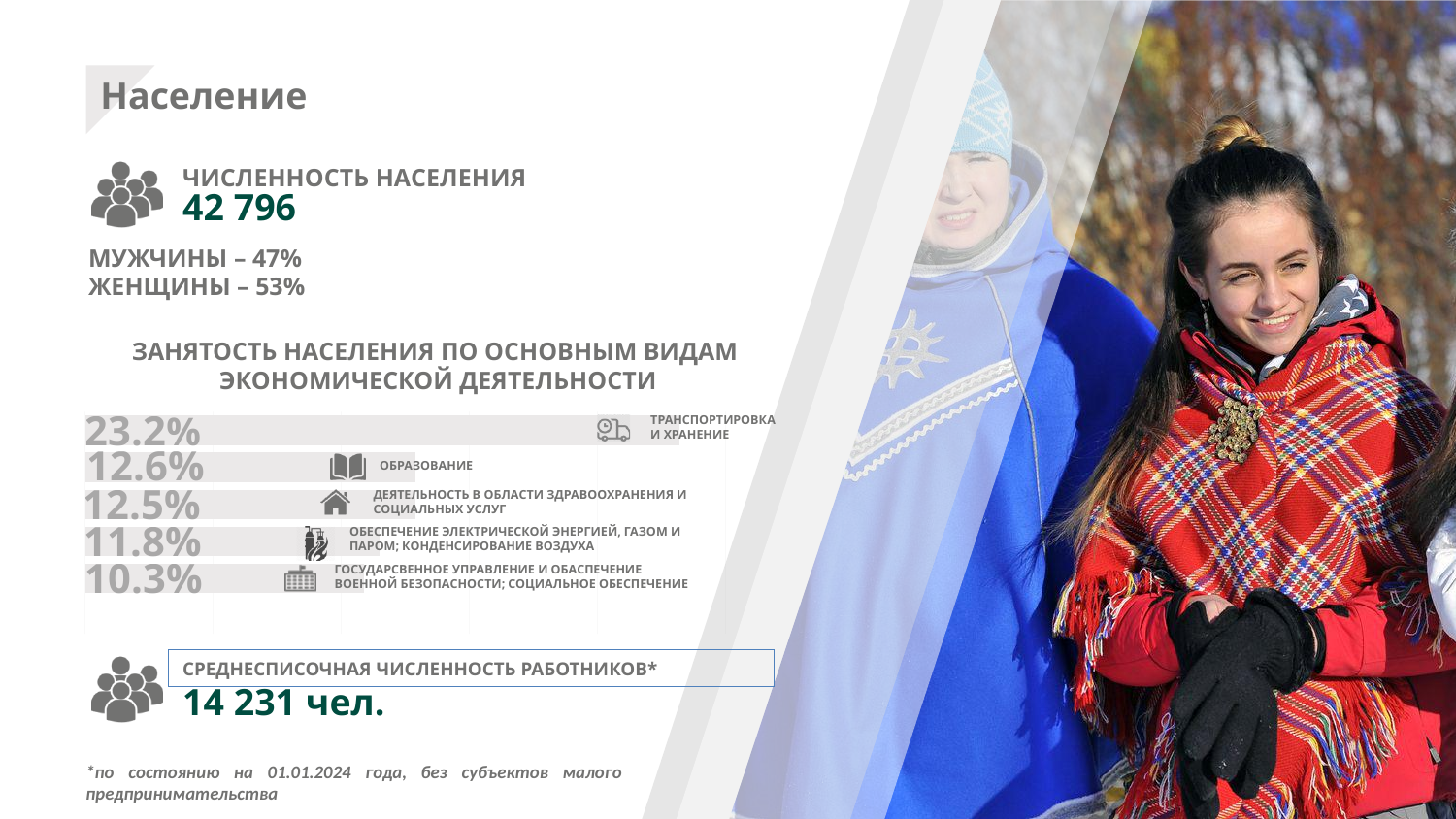
How many percentage points higher is the share for транспортировка и хранение than for образование? 10.6 Which type of economic activity has the lowest share of employment among those shown? Государственное управление и обеспечение военной безопасности; социальное обеспечение Which type of economic activity has the highest share of employment? Транспортировка и хранение Which has a larger share of employment: транспортировка и хранение or обеспечение электрической энергией, газом и паром? Транспортировка и хранение What kind of chart is used to show employment by type of economic activity? Bar chart What share of employment is in государственное управление и обеспечение военной безопасности; социальное обеспечение? 10.3% What is the difference in percentage points between транспортировка и хранение and государственное управление? 12.9 How many types of economic activity are shown in the employment chart? 5 What share of employment is in транспортировка и хранение? 23.2% What share of employment is in обеспечение электрической энергией, газом и паром; кондиционирование воздуха? 11.8% What share of employment is in деятельность в области здравоохранения и социальных услуг? 12.5% What share of employment is in образование? 12.6%